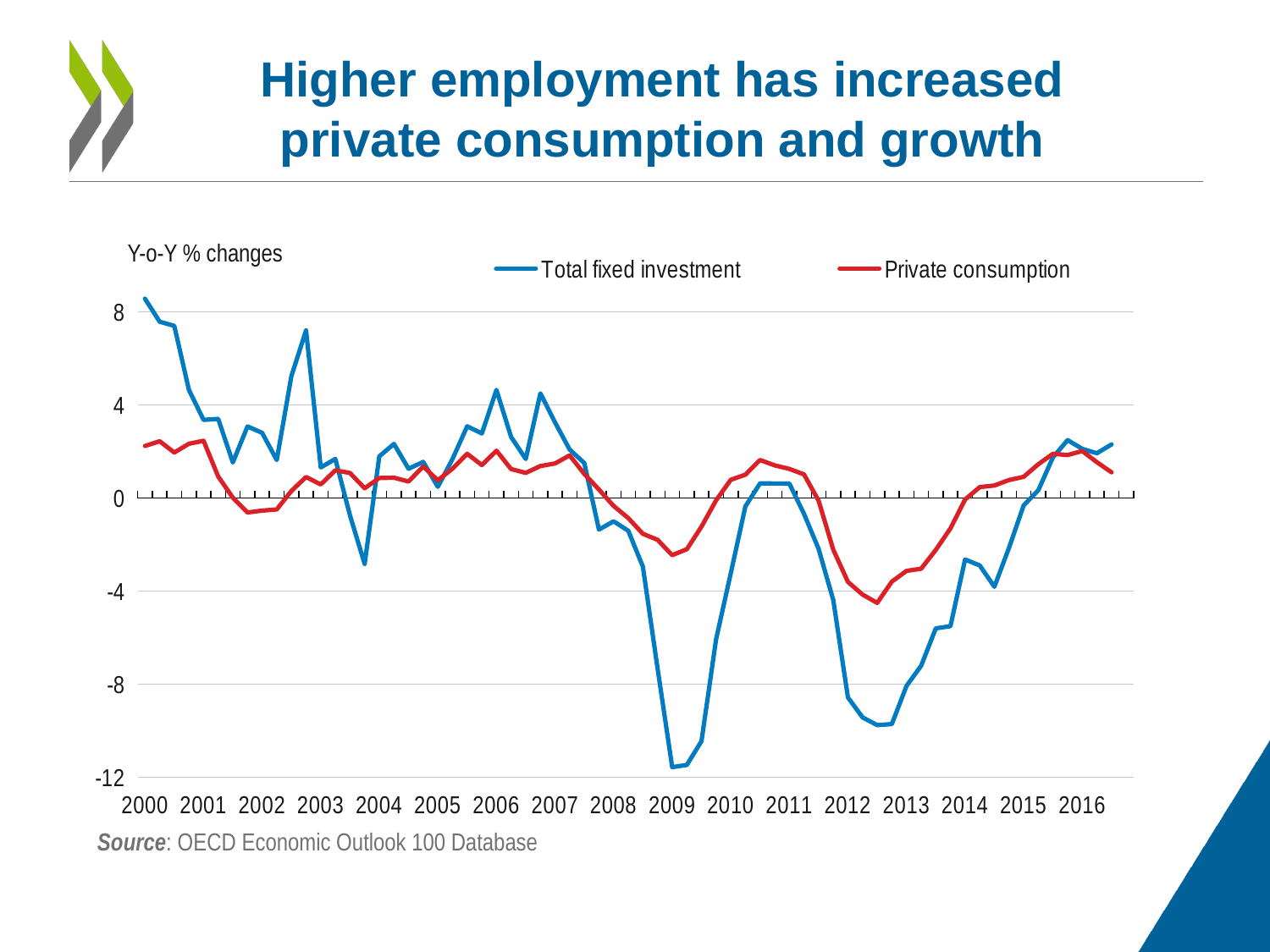
Does Total fixed investment rise or fall between 2013 and 2015? rise How many series does the legend list? 2 Is the value for Total fixed investment at the start of 2000 greater or less than 4? greater Which series reaches the highest value on the chart? Total fixed investment What unit label is shown above the y axis? Y-o-Y % changes Is the lowest value of Total fixed investment in 2009 greater or less than -8? less What kind of chart is shown on the slide? line chart What are the two series named in the legend? Total fixed investment and Private consumption In 2009, which series is lower, Total fixed investment or Private consumption? Total fixed investment How many years are labelled on the x axis? 17 Is the lowest value of Private consumption around 2012-2013 greater or less than -8? greater Which series reaches the lowest value on the chart? Total fixed investment